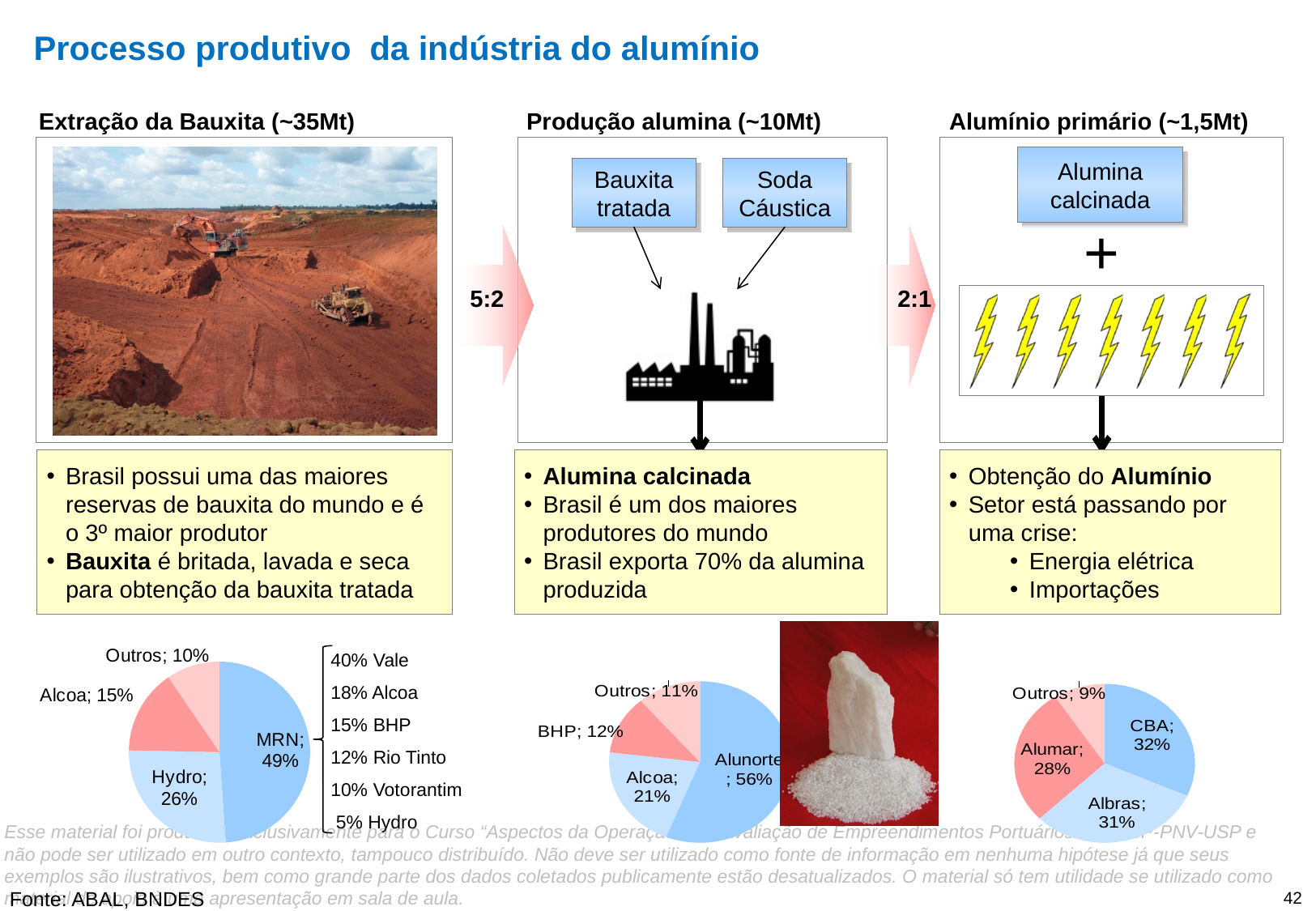
In the middle pie chart, which is larger, Alcoa or BHP? Alcoa In the left pie chart, which category has the smallest slice? Outros In the right pie chart, what share does Alumar hold? 28% In the middle pie chart, what is the difference between the Alunorte and Alcoa shares? 35% In the middle pie chart, what share does Alunorte hold? 56% In the left pie chart, what is the difference between the Hydro and Alcoa shares? 11% What type of chart is used for the three charts at the bottom of the slide? Pie chart In the left pie chart, what share does MRN hold? 49% In the right pie chart, what is the difference between the CBA and Outros shares? 23% In the left pie chart, which category has the largest slice? MRN In the right pie chart, which category has the smallest slice? Outros How many slices does the left pie chart have? 4